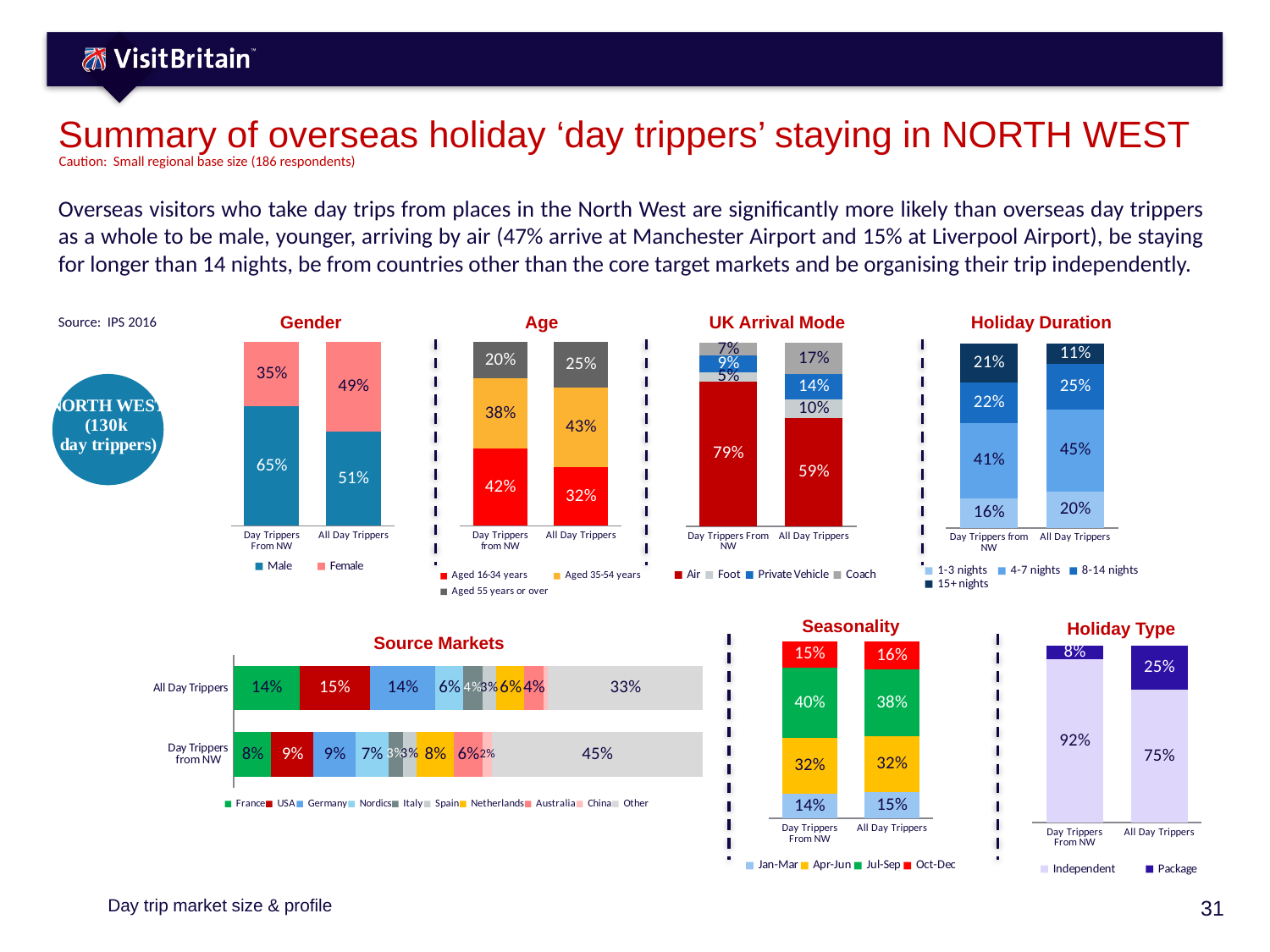
In the Age chart, what percentage of All Day Trippers are aged 35-54 years? 43% In the UK Arrival Mode chart, how many series does the legend list? 4 In the Holiday Duration chart, what percentage of All Day Trippers stay 15+ nights? 11% In the Gender chart, what is the difference between the male share of Day Trippers From NW and the male share of All Day Trippers? 14 percentage points In the UK Arrival Mode chart, what percentage of Day Trippers From NW arrive by air? 79% In the Holiday Type chart, what percentage of All Day Trippers are on a package holiday? 25% In the Source Markets chart, what percentage of Day Trippers from NW come from 'Other' markets? 45% In the Holiday Duration chart, which group has the larger share staying 15+ nights, Day Trippers from NW or All Day Trippers? Day Trippers from NW In the Age chart, which age group is the largest among Day Trippers from NW? Aged 16-34 years In the Gender chart, what percentage of Day Trippers From NW are male? 65% What type of chart is the Source Markets chart? Stacked bar chart In the Seasonality chart, which quarter has the highest share of Day Trippers From NW? Jul-Sep